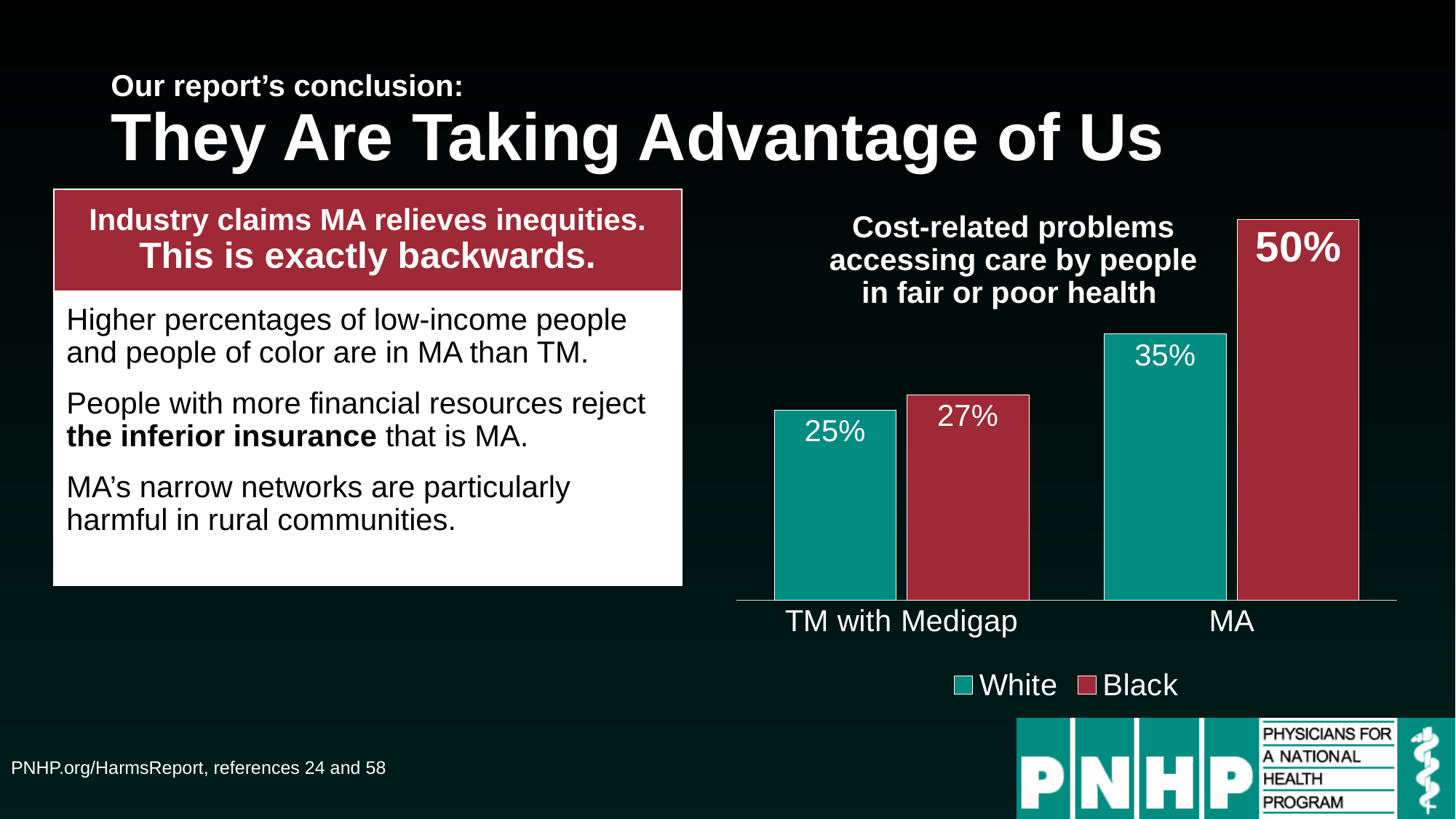
What is the value for White people with TM with Medigap? 25% What is the difference between the Black values for MA and TM with Medigap? 23% Which group and plan combination has the highest value? Black, MA How many series does the legend list? 2 What is the value for Black people with TM with Medigap? 27% What is the value for White people in MA? 35% How many categories are shown on the x axis? 2 What kind of chart is shown? Bar chart Which group and plan combination has the lowest value? White, TM with Medigap What is the difference between the Black and White values for MA? 15% Which is larger, the White value for MA or the Black value for TM with Medigap? White value for MA What is the value for Black people in MA? 50%